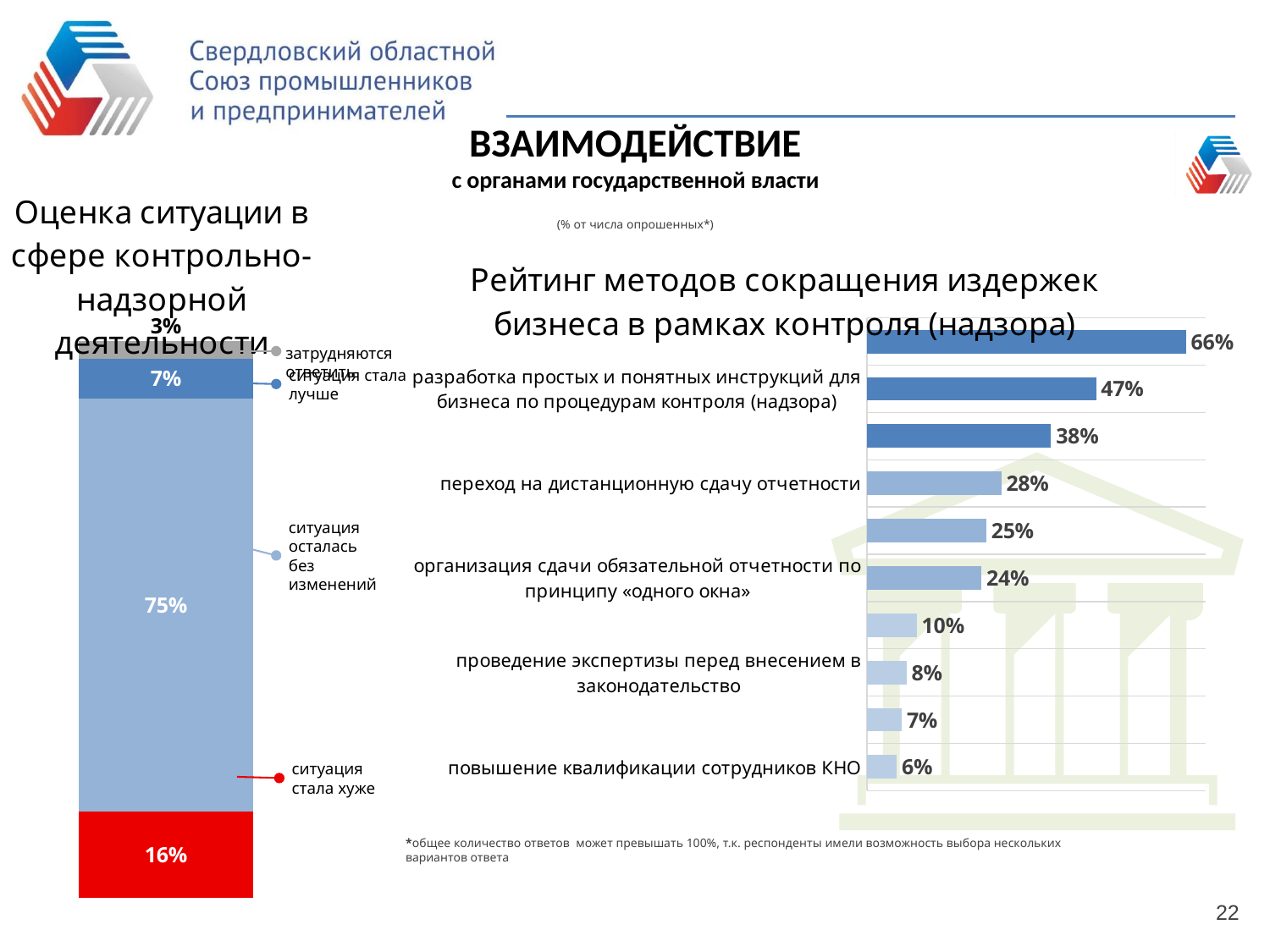
In the chart 'Оценка ситуации в сфере контрольно-надзорной деятельности', what share of respondents said the situation became worse (ситуация стала хуже)? 16% In the chart 'Оценка ситуации в сфере контрольно-надзорной деятельности', which response has the largest share? ситуация осталась без изменений In the chart 'Рейтинг методов сокращения издержек бизнеса в рамках контроля (надзора)', what is the difference between the two largest values, 66% and 47%? 19 percentage points In the chart 'Рейтинг методов сокращения издержек бизнеса в рамках контроля (надзора)', what is the value for 'повышение квалификации сотрудников КНО'? 6% In the chart 'Оценка ситуации в сфере контрольно-надзорной деятельности', by how many percentage points does 'ситуация осталась без изменений' exceed 'ситуация стала хуже'? 59 percentage points In the chart 'Рейтинг методов сокращения издержек бизнеса в рамках контроля (надзора)', what is the highest value shown? 66% In the chart 'Рейтинг методов сокращения издержек бизнеса в рамках контроля (надзора)', how many bars are plotted? 10 In the chart 'Рейтинг методов сокращения издержек бизнеса в рамках контроля (надзора)', what is the lowest value shown? 6% In the chart 'Оценка ситуации в сфере контрольно-надзорной деятельности', what share of respondents said the situation remained unchanged (ситуация осталась без изменений)? 75% In the chart 'Рейтинг методов сокращения издержек бизнеса в рамках контроля (надзора)', what is the value for 'переход на дистанционную сдачу отчетности'? 28% What type of chart is 'Рейтинг методов сокращения издержек бизнеса в рамках контроля (надзора)'? Bar chart In the chart 'Оценка ситуации в сфере контрольно-надзорной деятельности', what share of respondents said the situation became better (ситуация стала лучше)? 7%